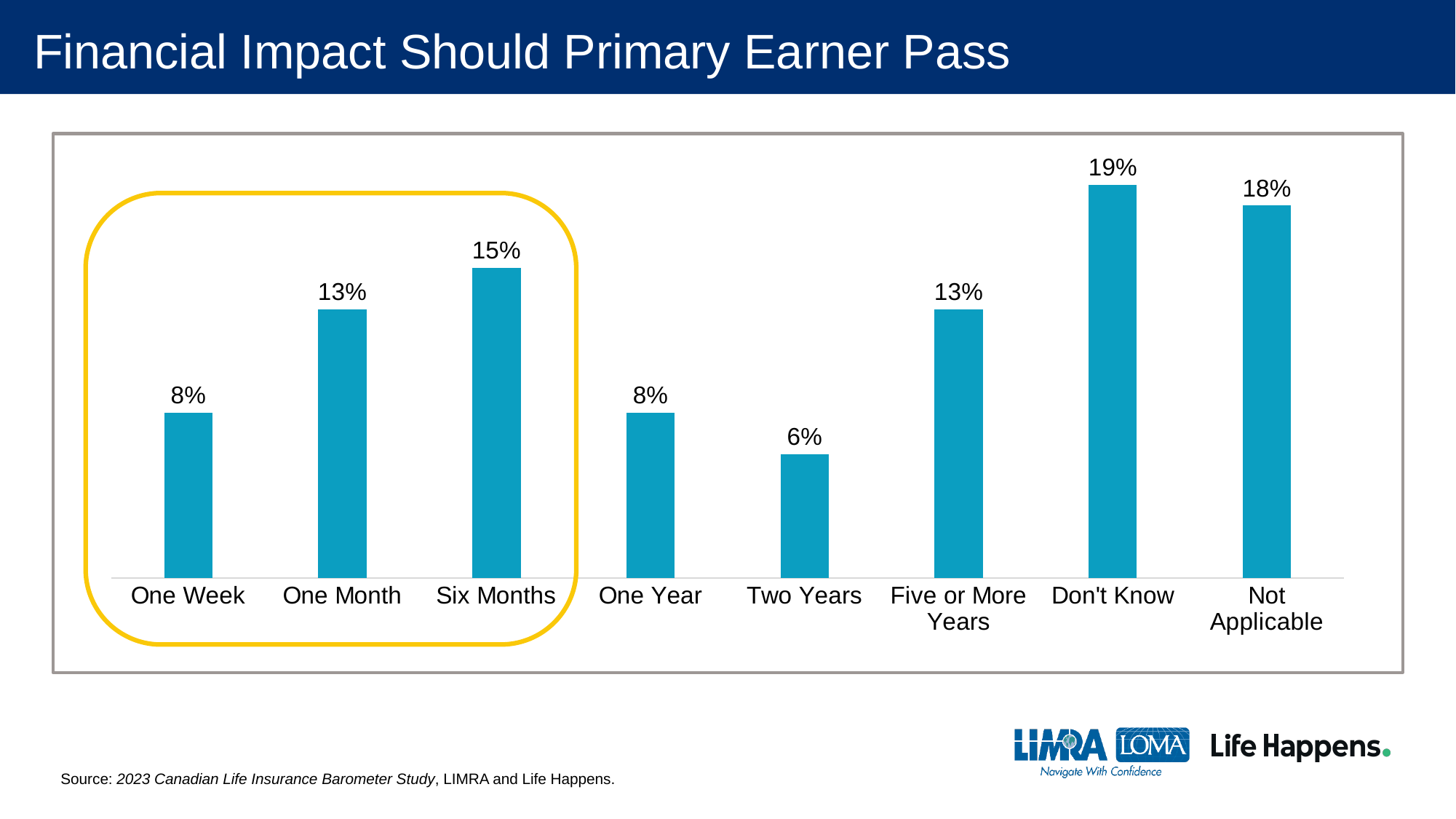
What is the difference between the values for Don't Know and Two Years? 13% What is the value for Two Years? 6% What is the difference between the values for Six Months and One Month? 2% Which category has the highest value? Don't Know Which three categories are enclosed by the yellow rounded outline? One Week, One Month, Six Months How many categories are shown on the x axis? 8 What is the value for Six Months? 15% Which is larger, the value for One Month or the value for One Year? One Month Which category has the lowest value? Two Years What is the value for One Week? 8% What is the value for Not Applicable? 18% What kind of chart is shown on the slide? Bar chart